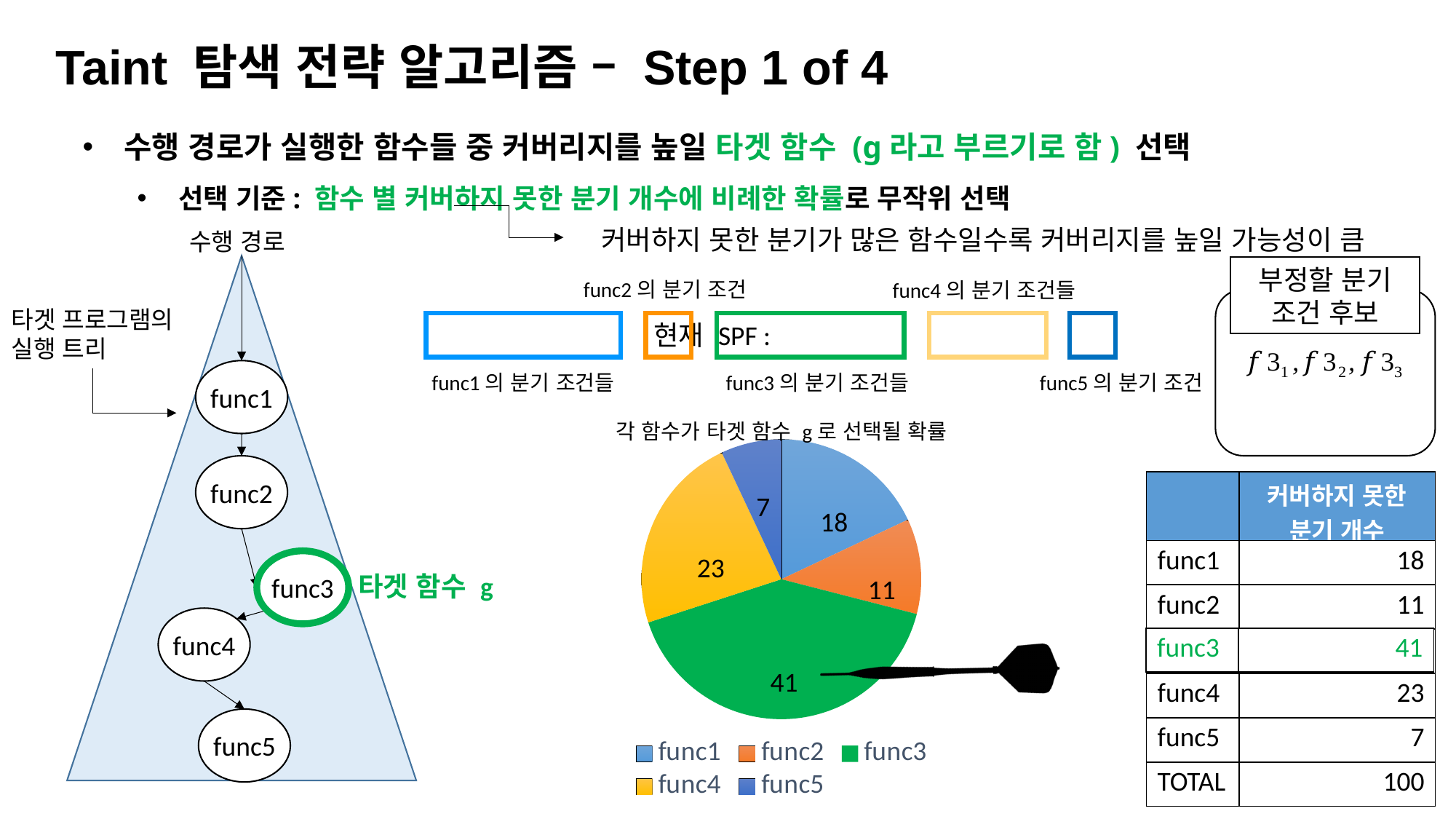
What share of the pie does func4 represent? 23% What is the value for func3 in the pie chart? 41 Which function has the largest slice in the pie chart? func3 What is the value for func1 in the pie chart? 18 Which function has the smallest slice in the pie chart? func5 Which is larger in the pie chart, func1 or func2? func1 What is the value for func5 in the pie chart? 7 What type of chart is shown on the slide? pie chart What is the difference between the values for func3 and func4 in the pie chart? 18 What colour is the func3 slice in the pie chart? green How many entries does the pie chart's legend list? 5 How many slices does the pie chart have? 5